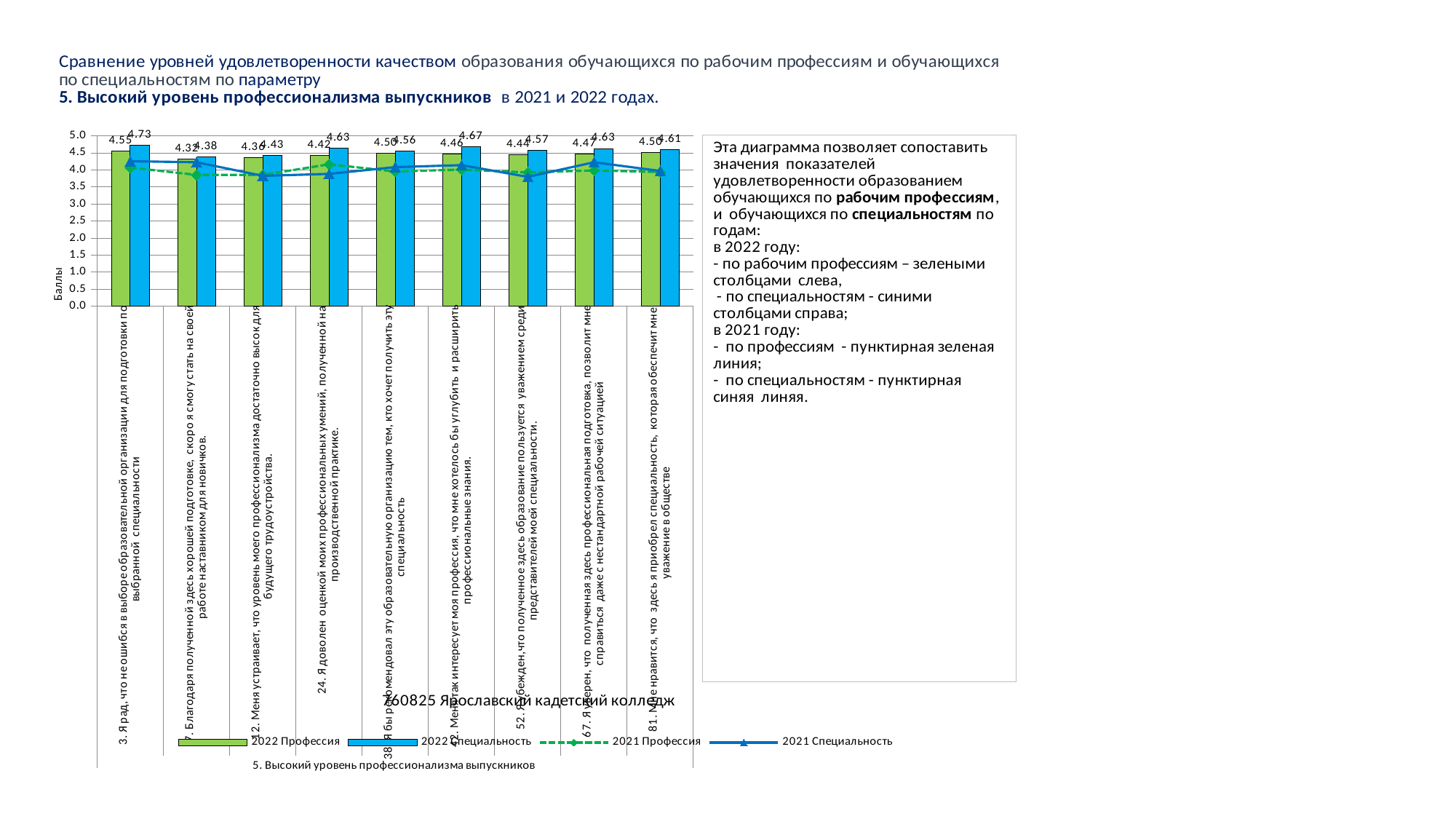
What is the value of the 2022 Специальность bar for statement 81 (Мне нравится, что здесь я приобрел специальность)? 4.61 How many statements (categories) are shown on the x axis? 9 Which statement has the highest 2022 Специальность value? 3. Я рад, что не ошибся в выборе образовательной организации для подготовки по выбранной специальности For statement 81, which is larger: the 2022 Профессия bar or the 2022 Специальность bar? 2022 Специальность How many series does the legend list? 4 What is the value of the 2022 Специальность bar for statement 3 (Я рад, что не ошибся в выборе образовательной организации)? 4.73 What is the difference between the 2022 Специальность and 2022 Профессия values for statement 24? 0.21 Which statement has the lowest 2022 Профессия value? 7. Благодаря полученной здесь хорошей подготовке, скоро я смогу стать на своей работе наставником для новичков Is the 2021 Профессия value for statement 12 greater or less than 4.5? less What kind of chart is shown on the slide? Combined bar and line chart What is the label of the vertical axis? Баллы What is the value of the 2022 Профессия bar for statement 24 (Я доволен оценкой моих профессиональных умений)? 4.42